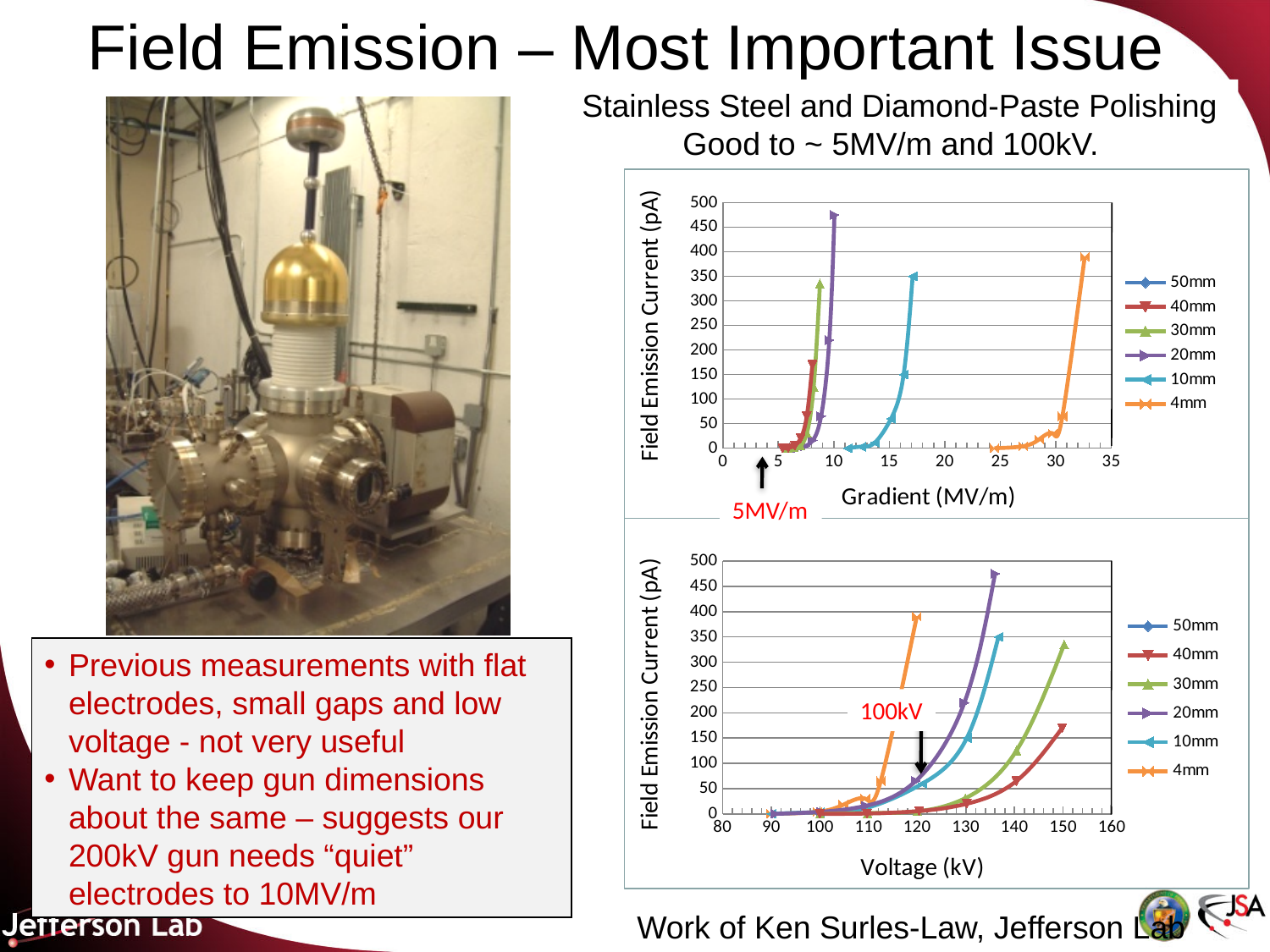
What is the x-axis label of the top chart? Gradient (MV/m) What is the y-axis label of the bottom chart? Field Emission Current (pA) In the top chart, is the peak field emission current of the 4mm series greater or less than 350? greater In the top chart, which series reaches the highest field emission current? 20mm In the bottom chart, which series reaches a higher peak field emission current, 20mm or 10mm? 20mm In the bottom chart, is the peak field emission current of the 20mm series greater or less than 450? greater In the top chart, is the gradient at which the 4mm series reaches its peak greater or less than 30? greater What kind of chart is the top chart (Field Emission Current vs Gradient)? line chart How many series does the legend of the top chart list? 6 In the top chart, which series reaches its peak current at the highest gradient? 4mm In the bottom chart, which series reaches its peak current at the lowest voltage? 4mm